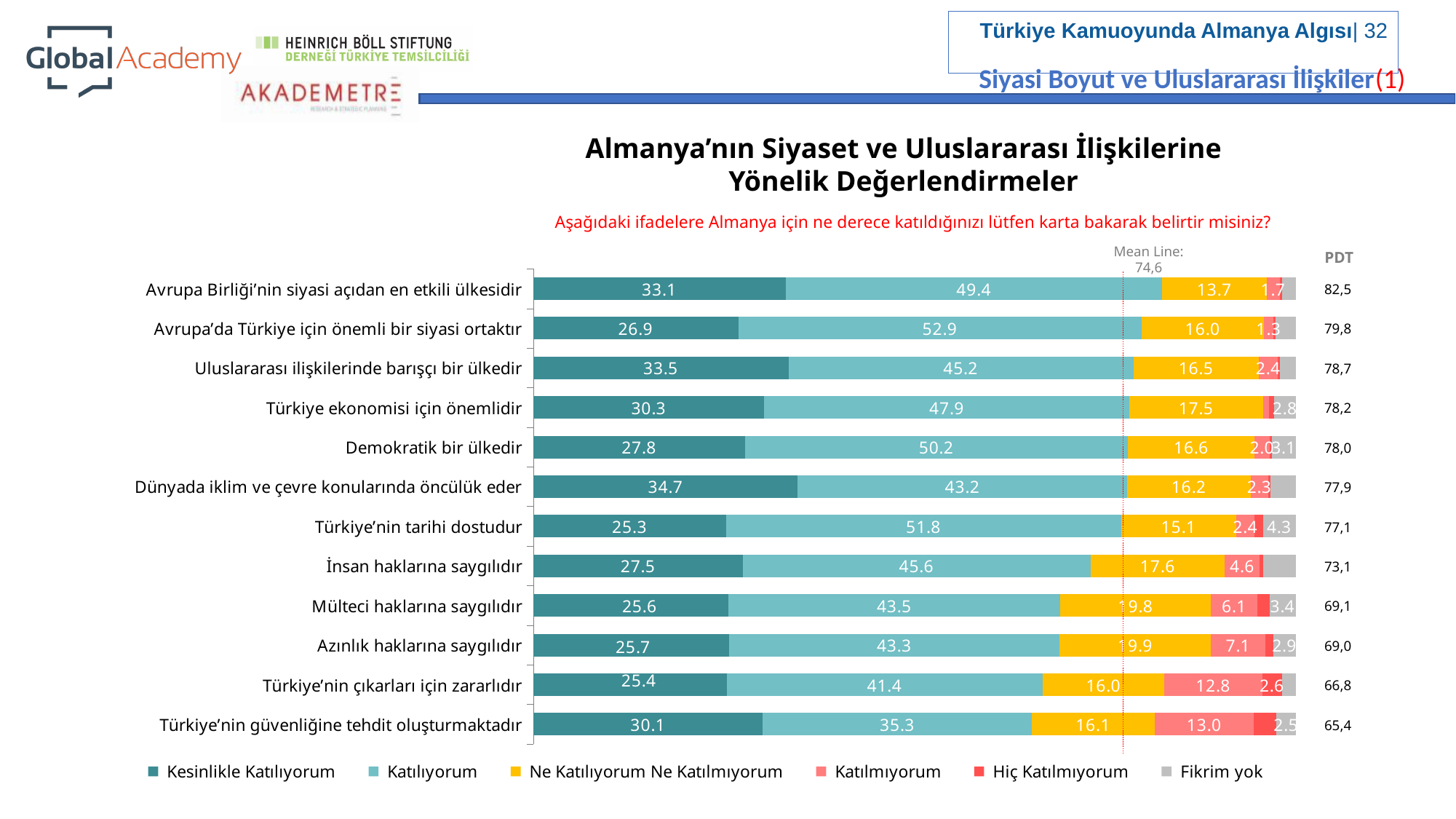
Which statement has the highest "Kesinlikle Katılıyorum" value? Dünyada iklim ve çevre konularında öncülük eder What value is given for the Mean Line on the chart? 74,6 What is the difference between the "Katılıyorum" and "Kesinlikle Katılıyorum" values for "Avrupa Birliği'nin siyasi açıdan en etkili ülkesidir"? 16.3 How many series does the legend list? 6 What is the value of "Kesinlikle Katılıyorum" for "Avrupa Birliği'nin siyasi açıdan en etkili ülkesidir"? 33.1 What is the value of "Katılıyorum" for "Avrupa'da Türkiye için önemli bir siyasi ortaktır"? 52.9 What is the PDT value shown for "Avrupa Birliği'nin siyasi açıdan en etkili ülkesidir"? 82,5 Which has the larger "Katılıyorum" value: "Demokratik bir ülkedir" or "Türkiye'nin tarihi dostudur"? Türkiye'nin tarihi dostudur How many statements (categories) are shown in the chart? 12 Which statement has the lowest "Katılıyorum" value? Türkiye'nin güvenliğine tehdit oluşturmaktadır What kind of chart is shown on the slide? Stacked bar chart What is the value of "Katılmıyorum" for "Türkiye'nin güvenliğine tehdit oluşturmaktadır"? 13.0